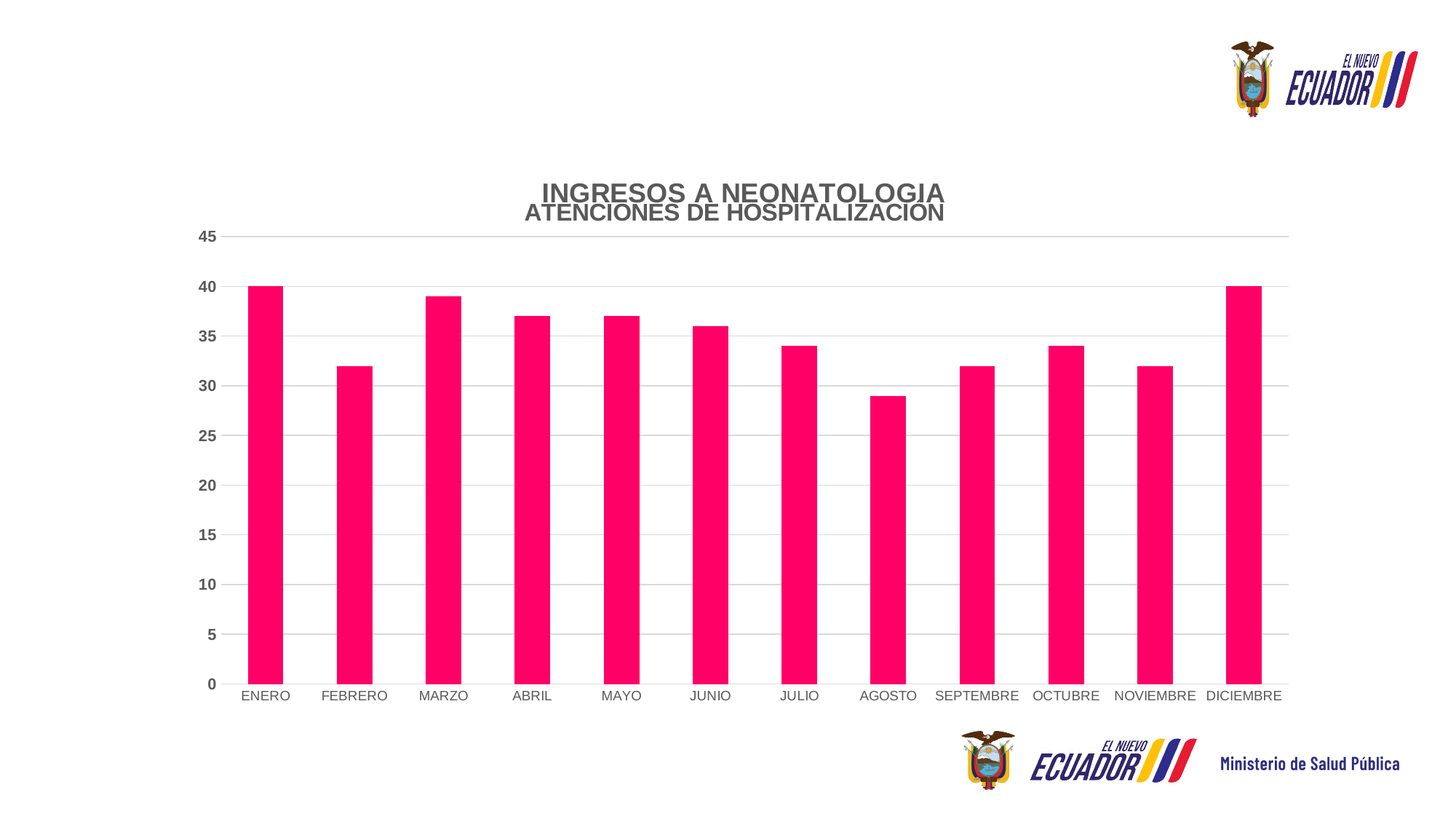
Which month has the lowest value? AGOSTO Is the value for JUNIO greater or less than 35? greater Is the value for FEBRERO greater or less than 35? less What is the value for ENERO? 40 Is the value for MARZO greater or less than 35? greater Which is larger, the value for JULIO or the value for AGOSTO? JULIO What is the value for DICIEMBRE? 40 Which is larger, the value for MARZO or the value for FEBRERO? MARZO What is the main title of the chart? INGRESOS A NEONATOLOGIA What kind of chart is shown on the slide? bar chart How many months are shown on the x axis? 12